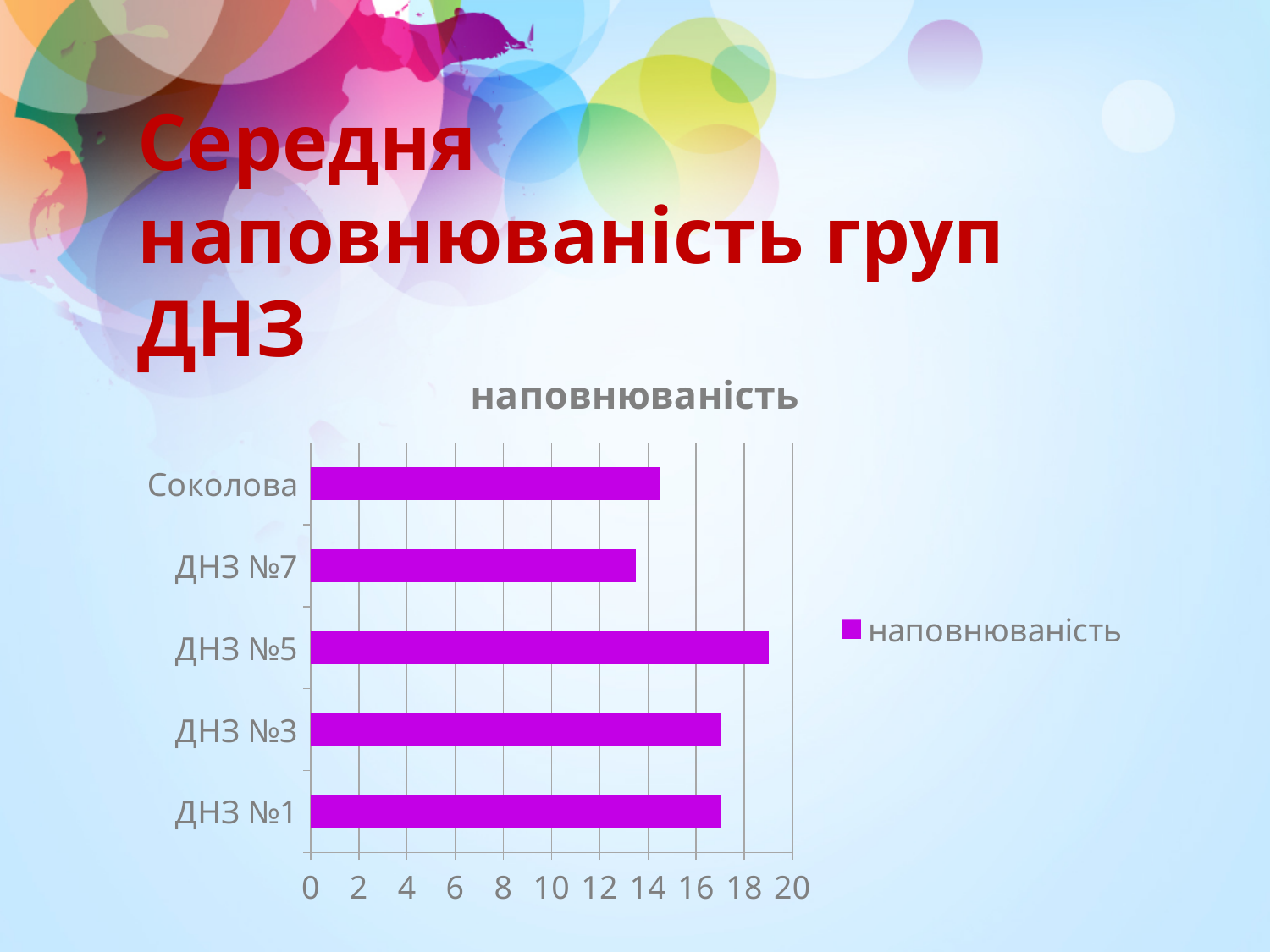
Which has a larger value, ДНЗ №5 or Соколова? ДНЗ №5 Which category has the lowest value in the chart? ДНЗ №7 Is the value for Соколова greater or less than 16? less How many categories are plotted in the chart? 5 What is the title of the chart? наповнюваність Is the value for ДНЗ №7 greater or less than 14? less Is the value for ДНЗ №1 greater or less than 16? greater What kind of chart is shown on the slide? bar chart How many series does the legend list? 1 Which category has the highest value in the chart? ДНЗ №5 Which has a larger value, ДНЗ №1 or ДНЗ №7? ДНЗ №1